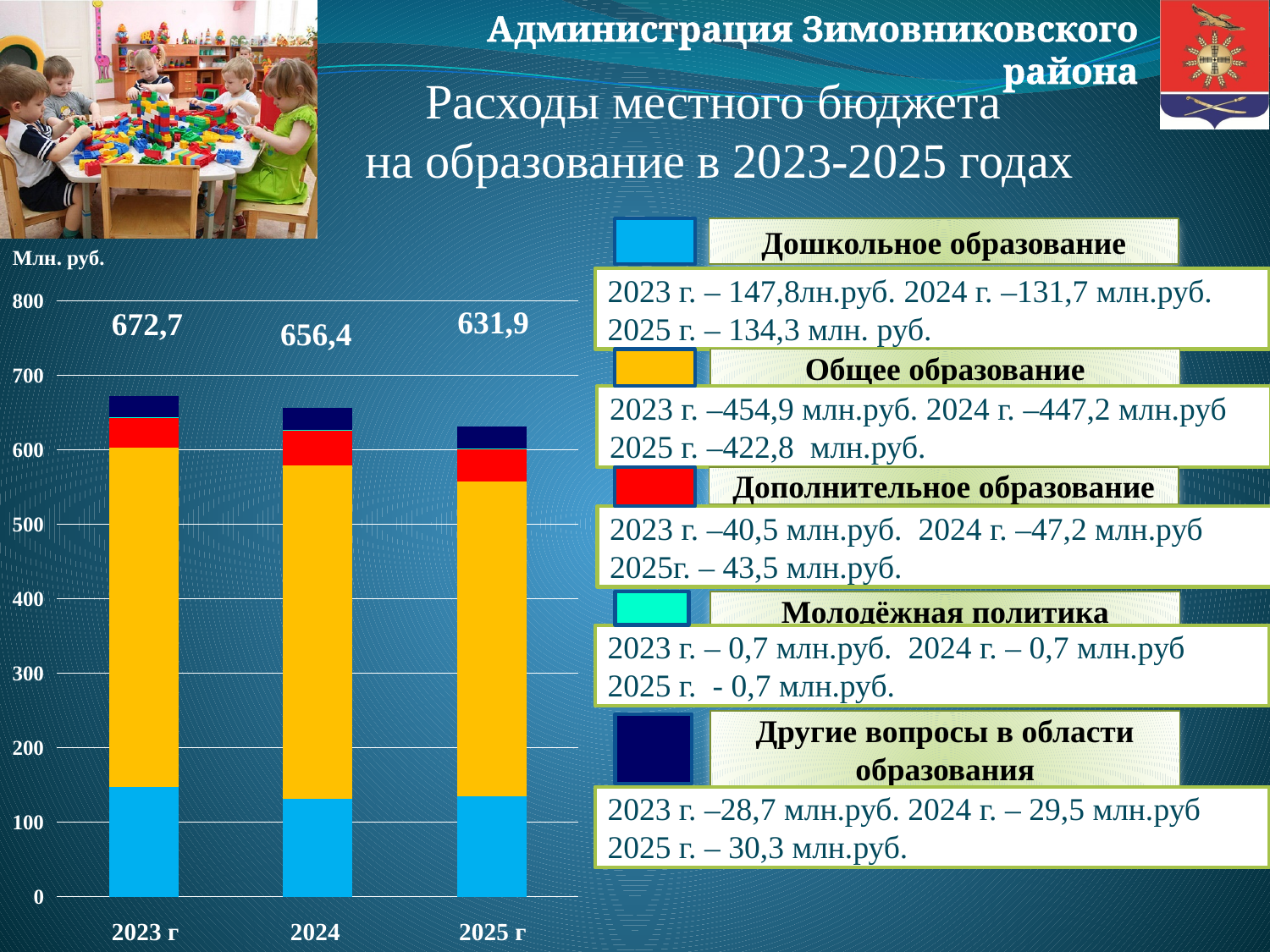
What is the difference between the total expenditure in 2023 and in 2024? 16,3 What is the expenditure on Дошкольное образование in 2024? 131,7 млн.руб. Which colour represents Общее образование in the chart? yellow Do the total expenditures rise or fall from 2023 to 2025? fall How many categories of expenditure does the legend list? 5 What is the expenditure on Общее образование in 2025? 422,8 млн.руб. What type of chart is shown on the slide? bar chart Which year has the highest total expenditure on education? 2023 г How many years (bars) are shown on the chart? 3 What is the total local budget expenditure on education shown for 2025? 631,9 What is the total local budget expenditure on education shown for 2023? 672,7 Which year has the lowest total expenditure on education? 2025 г